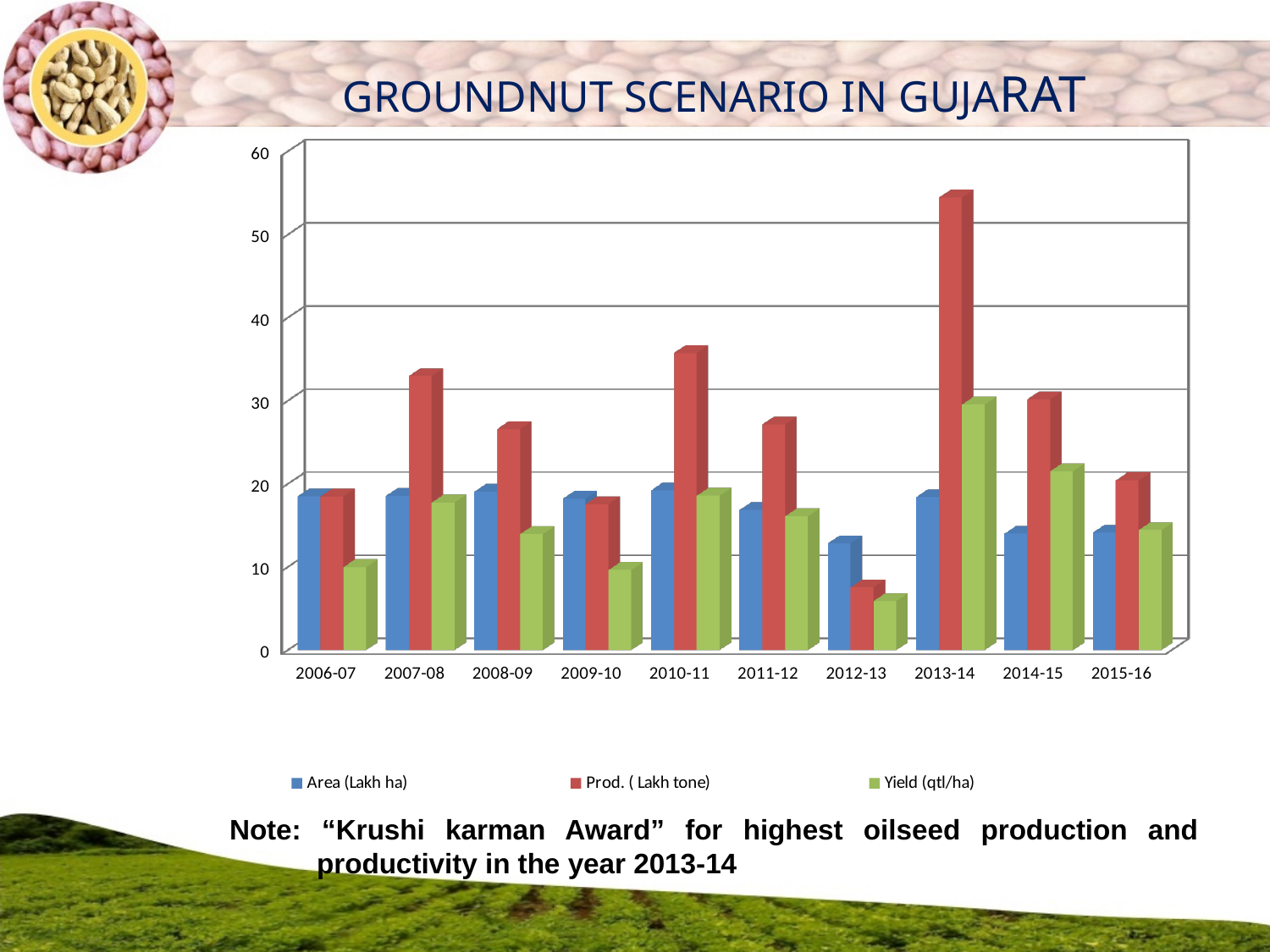
How many years are shown on the x axis? 10 Which year has the lowest Yield (qtl/ha) value? 2012-13 Is the Prod. (Lakh tone) value for 2013-14 greater or less than 50? greater Which year has the highest Prod. (Lakh tone) value? 2013-14 What is the title of the chart? GROUNDNUT SCENARIO IN GUJARAT Is the Yield (qtl/ha) value for 2006-07 greater or less than 20? less How many series does the legend list? 3 What kind of chart is shown on the slide? bar chart Is the Prod. (Lakh tone) value for 2010-11 greater or less than 30? greater Which year has the lowest Prod. (Lakh tone) value? 2012-13 Which year has the highest Yield (qtl/ha) value? 2013-14 Which is larger, the Prod. (Lakh tone) value for 2007-08 or for 2008-09? 2007-08